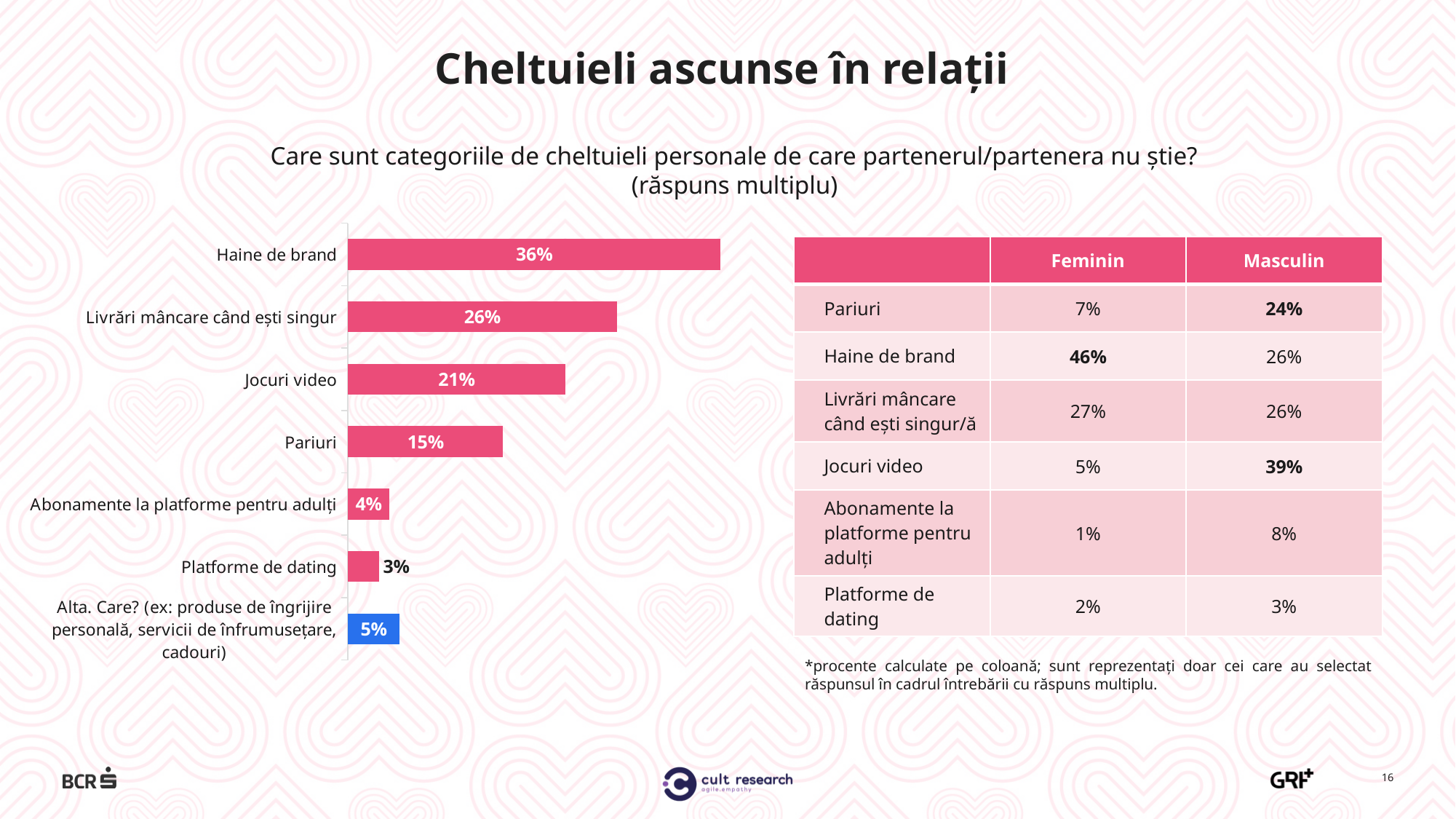
Which bar in the chart is coloured blue instead of pink? Alta. Care? (ex: produse de îngrijire personală, servicii de înfrumusețare, cadouri) What is the value for Platforme de dating? 3% What kind of chart is shown on the slide? bar chart Which is larger, the value for Jocuri video or the value for Pariuri? Jocuri video What is the value for Haine de brand? 36% Which category has the highest value? Haine de brand Which category has the lowest value? Platforme de dating What is the difference between the values for Haine de brand and Livrări mâncare când ești singur? 10 percentage points What is the value for Pariuri? 15% How many categories are shown in the bar chart? 7 What is the value for Jocuri video? 21% What is the value for Livrări mâncare când ești singur? 26%